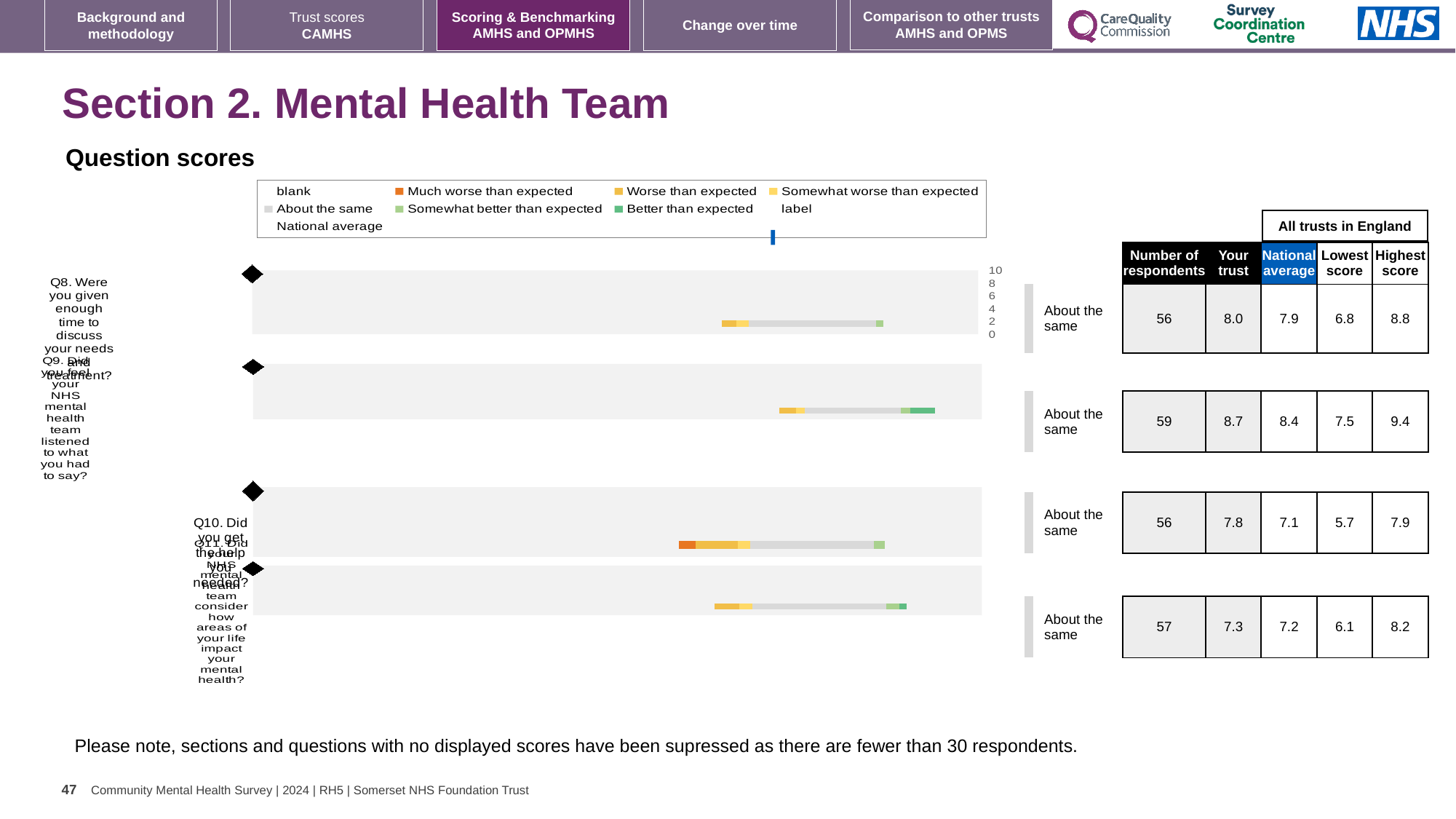
How many questions (Q8 to Q11) have a score bar shown on the slide? 4 What kind of chart is used to show the question scores for Q8 to Q11? bar chart For Q8, which is larger in the table: the 'Your trust' score or the national average? Your trust In the table next to the charts, what is the national average for Q10? 7.1 For Q9, what is the difference between the 'Your trust' score and the national average in the table? 0.3 Which question has the lowest 'Your trust' score in the table? Q11 Which question has the highest 'Your trust' score in the table? Q9 What benchmark category is shown next to each of the four question bars? About the same In the table next to the charts, what is the 'Your trust' score for Q9? 8.7 In the table next to the charts, what is the highest score across all trusts in England for Q9? 9.4 In the table next to the charts, what is the number of respondents for Q8? 56